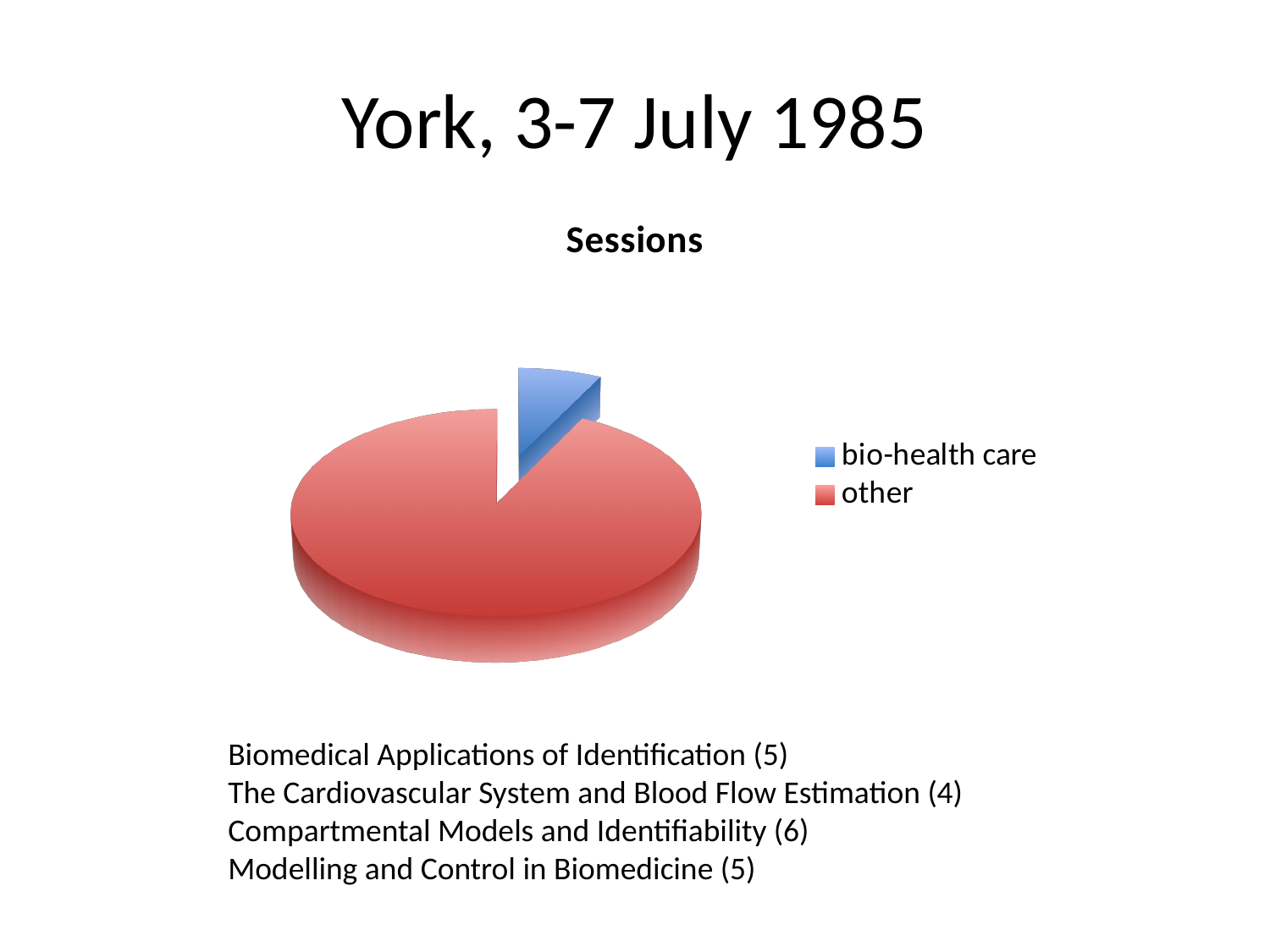
What kind of chart is shown on the slide? pie chart How many entries does the chart legend list? 2 How many slices does the pie chart have? 2 Which slice is larger, bio-health care or other? other What colour is the bio-health care slice? blue What is the title of the chart? Sessions Which category has the largest slice of the pie? other Which category has the smallest slice of the pie? bio-health care